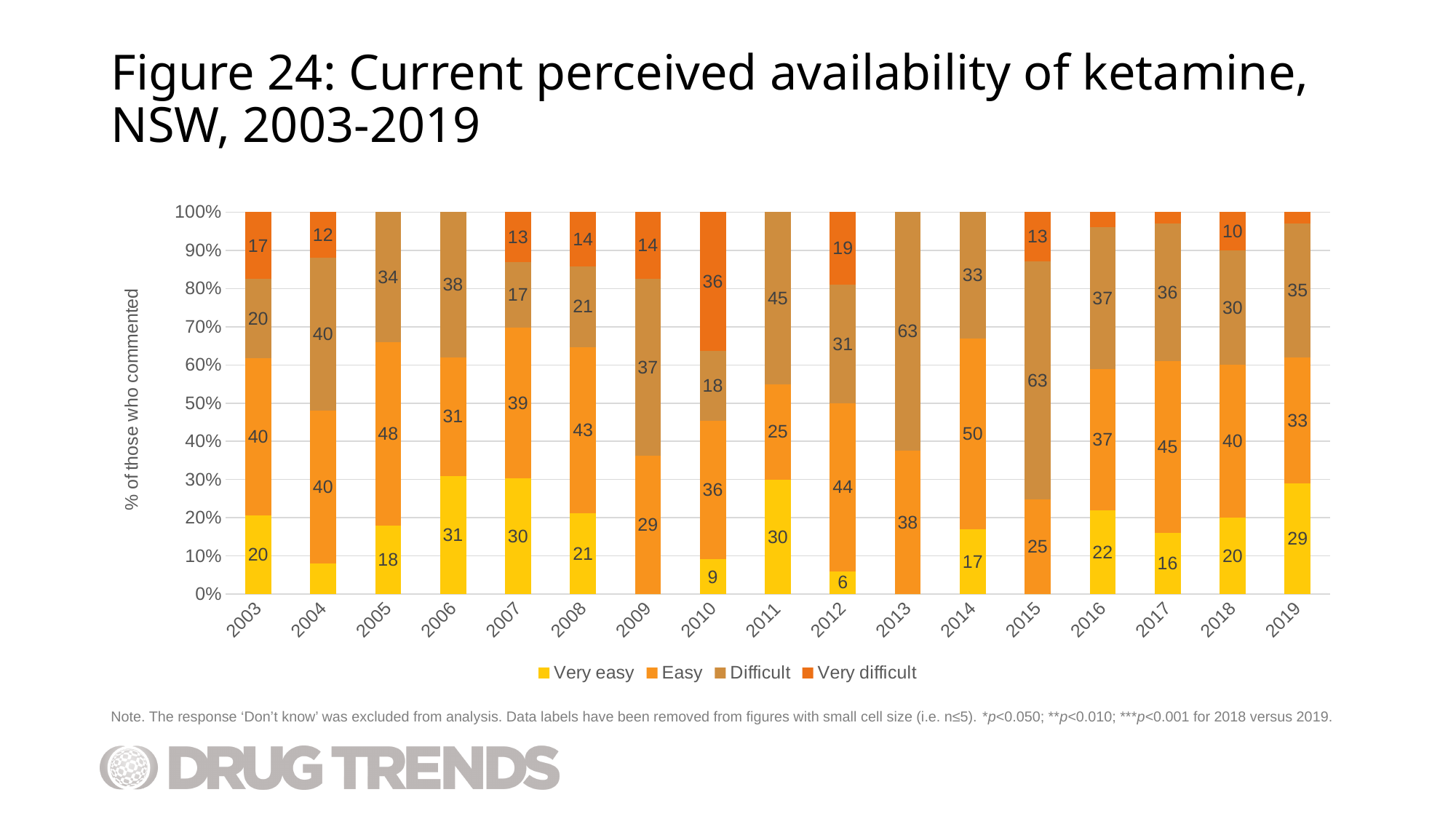
What is the title of the y axis? % of those who commented Is the 'Very easy' value for 2004 greater or less than 10%? less In which year is the 'Very difficult' value highest? 2010 How many series does the legend list? 4 In which year is the 'Easy' value highest? 2014 What is the 'Very easy' value for 2019? 29 How many years are shown on the x axis? 17 What is the 'Very difficult' value for 2010? 36 Which year has the larger 'Difficult' value, 2011 or 2012? 2011 What kind of chart is shown on the slide? Stacked bar chart What is the difference between the 'Easy' value in 2018 and in 2019? 7 What is the 'Difficult' value for 2013? 63